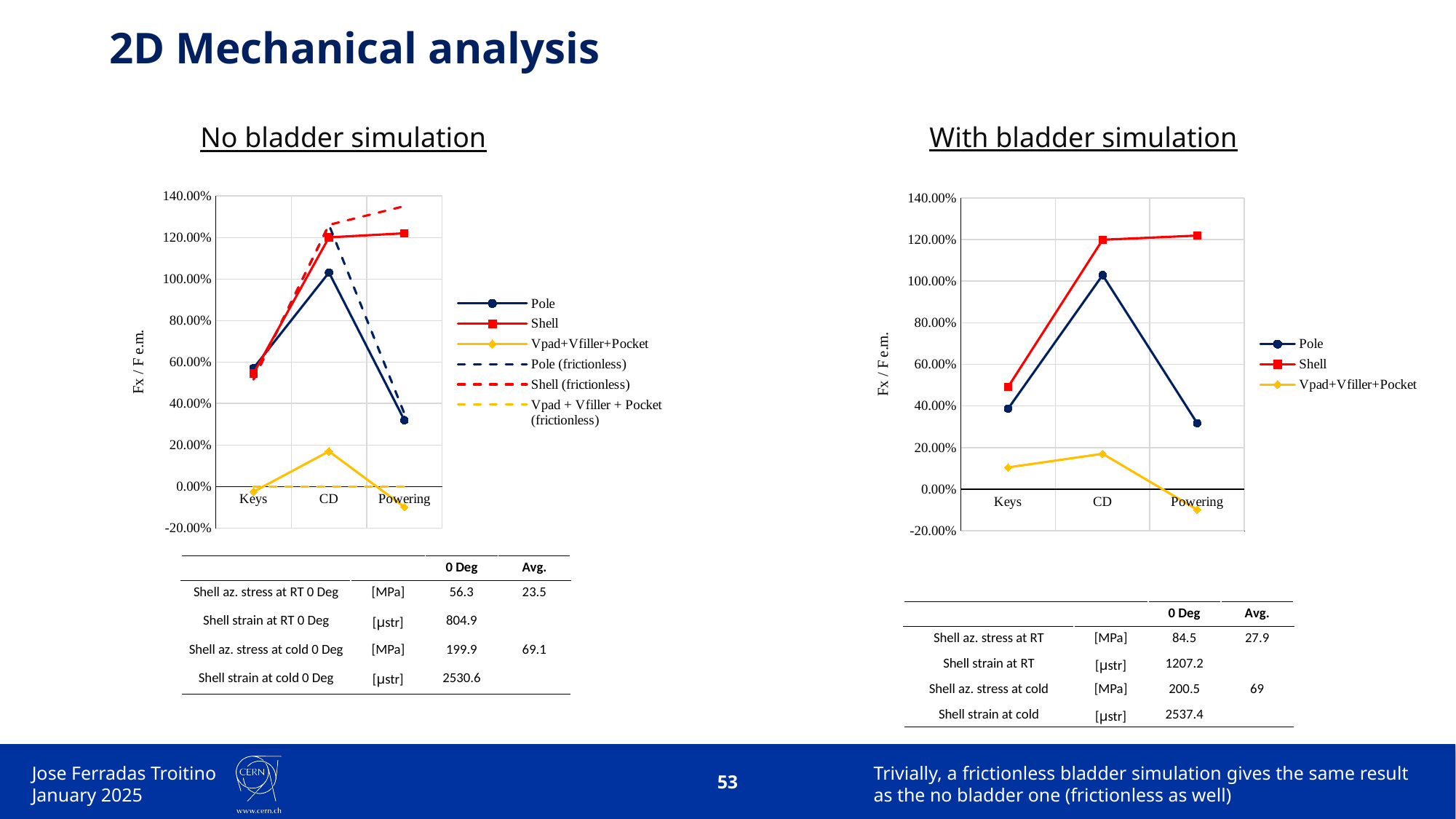
In the 'No bladder simulation' chart, at which category does the Pole series reach its highest value? CD How many series does the legend of the 'No bladder simulation' chart list? 6 In the 'With bladder simulation' chart, is the value of the Shell series at Keys greater or less than 60.00%? less In the 'With bladder simulation' chart, at which category is the Shell series lowest? Keys In the 'No bladder simulation' chart, does the Pole series rise or fall from CD to Powering? fall In the 'With bladder simulation' chart, which series has the larger value at Keys, Shell or Pole? Shell In the 'With bladder simulation' chart, at which category is the Pole series lowest? Powering In the 'No bladder simulation' chart, is the value of the Pole series at Powering greater or less than 40.00%? less How many series does the legend of the 'With bladder simulation' chart list? 3 What kind of chart is the 'No bladder simulation' chart? line chart In the 'With bladder simulation' chart, is the value of the Vpad+Vfiller+Pocket series at Powering greater or less than 0.00%? less How many categories are shown on the x axis of the 'With bladder simulation' chart? 3